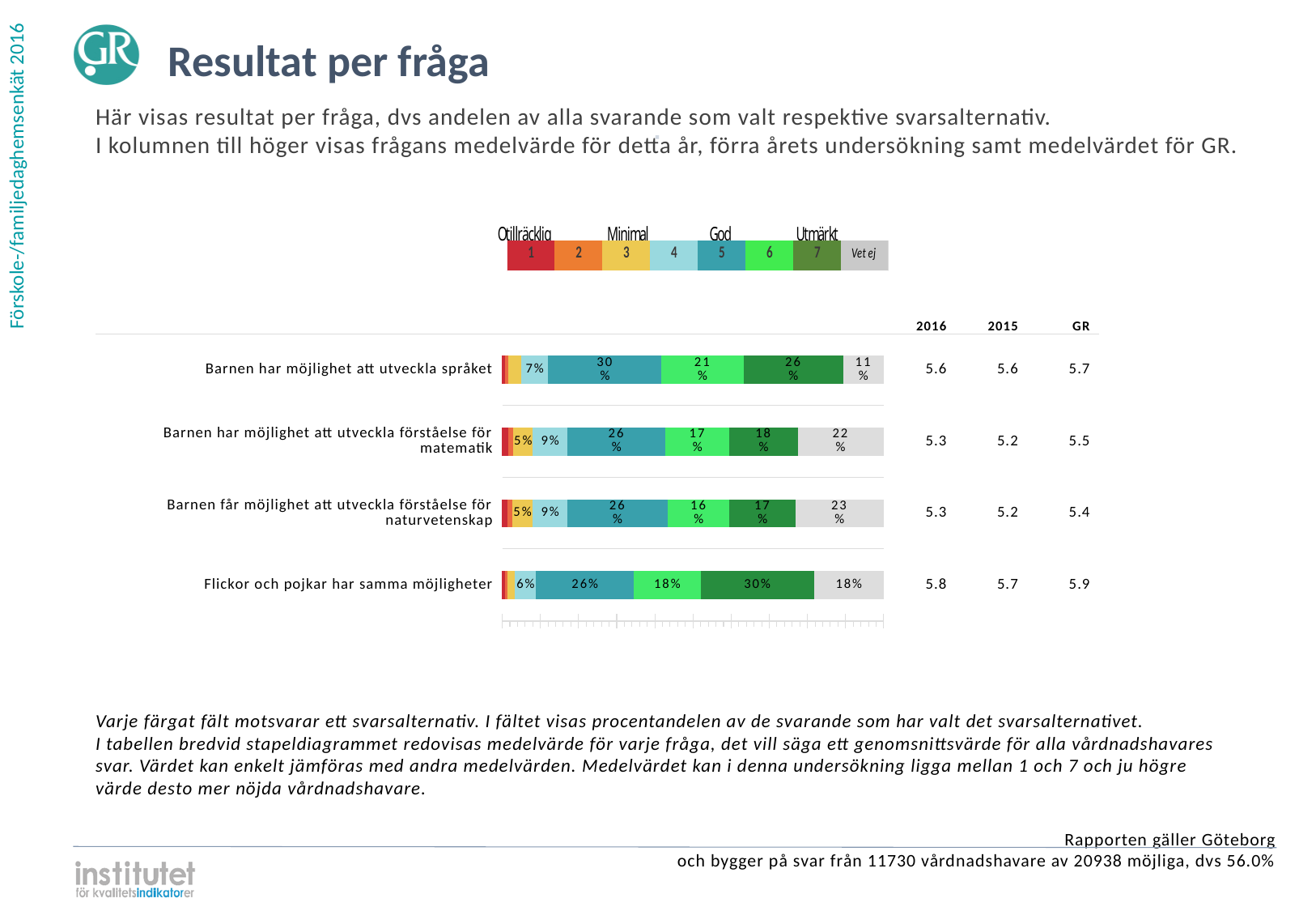
What is the 2016 mean value shown next to the bar for 'Flickor och pojkar har samma möjligheter'? 5.8 What percentage chose answer option 6 for 'Barnen får möjlighet att utveckla förståelse för naturvetenskap'? 16% Which question has the highest share of answer option 7 (Utmärkt)? Flickor och pojkar har samma möjligheter Which is larger: the share of answer option 5 for 'Barnen har möjlighet att utveckla språket' or for 'Flickor och pojkar har samma möjligheter'? Barnen har möjlighet att utveckla språket What kind of chart is shown on the slide? Stacked bar chart Which question has the lowest 'Vet ej' share? Barnen har möjlighet att utveckla språket What are the four named answer levels shown in the legend above the chart? Otillräcklig, Minimal, God, Utmärkt How many questions (categories) are plotted in the bar chart? 4 What percentage of respondents chose answer option 5 (God) for 'Barnen har möjlighet att utveckla språket'? 30% What is the 'Vet ej' share for 'Barnen har möjlighet att utveckla förståelse för matematik'? 22% What is the difference in percentage points between the Utmärkt (7) share for 'Barnen har möjlighet att utveckla språket' and for 'Barnen får möjlighet att utveckla förståelse för naturvetenskap'? 9 percentage points What percentage chose answer option 7 (Utmärkt) for 'Flickor och pojkar har samma möjligheter'? 30%